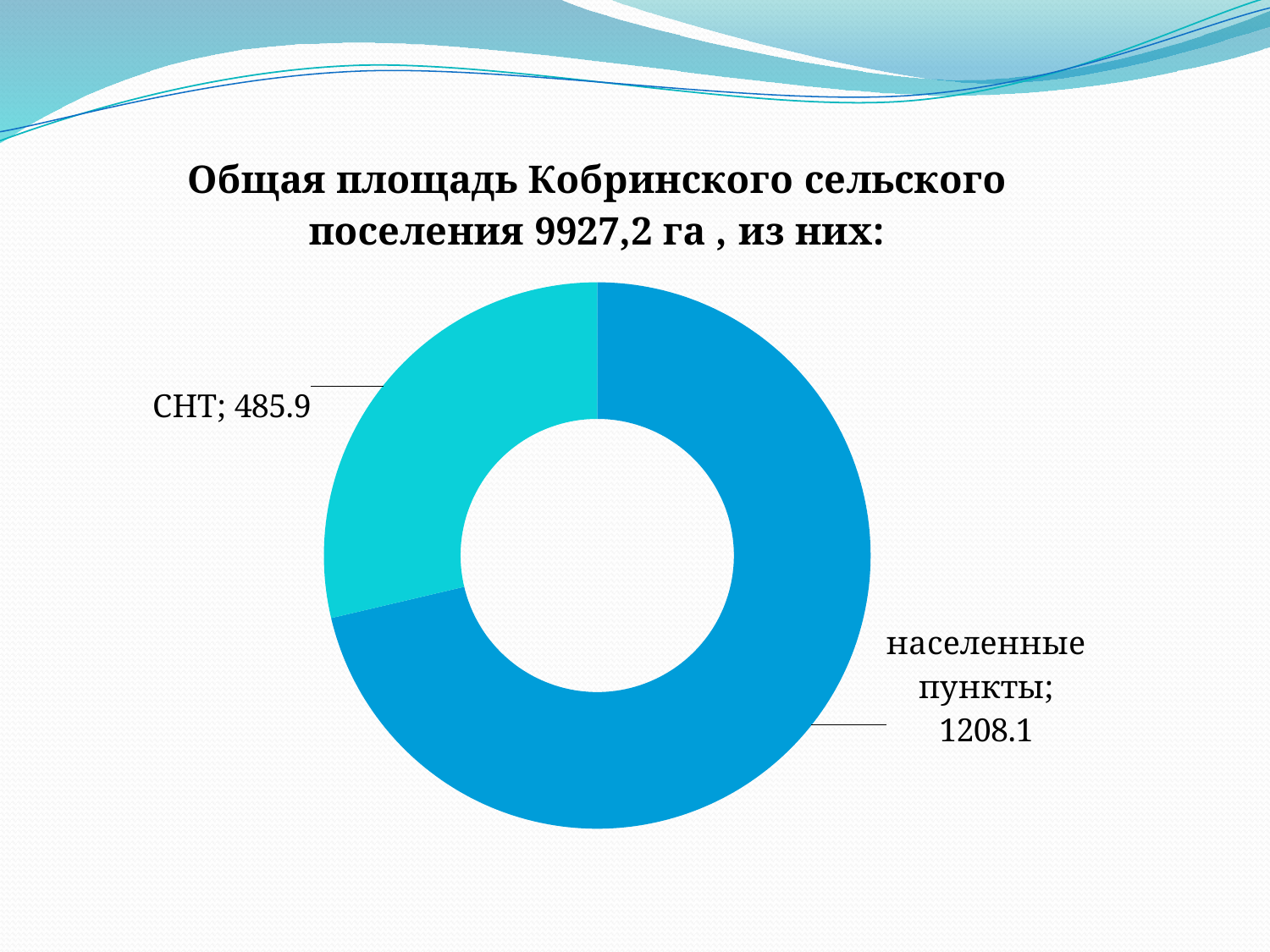
What is the total of the two values shown in the chart? 1694.0 What total area in hectares is stated in the chart title? 9927,2 га Which is larger, the value for СНТ or the value for населенные пункты? населенные пункты What is the difference between the values for населенные пункты and СНТ? 722.2 What value is shown for СНТ? 485.9 What is the title of the chart? Общая площадь Кобринского сельского поселения 9927,2 га , из них: Which category has the largest slice? населенные пункты What value is shown for населенные пункты? 1208.1 Which category has the smallest slice? СНТ What kind of chart is shown on the slide? doughnut chart How many categories are shown in the chart? 2